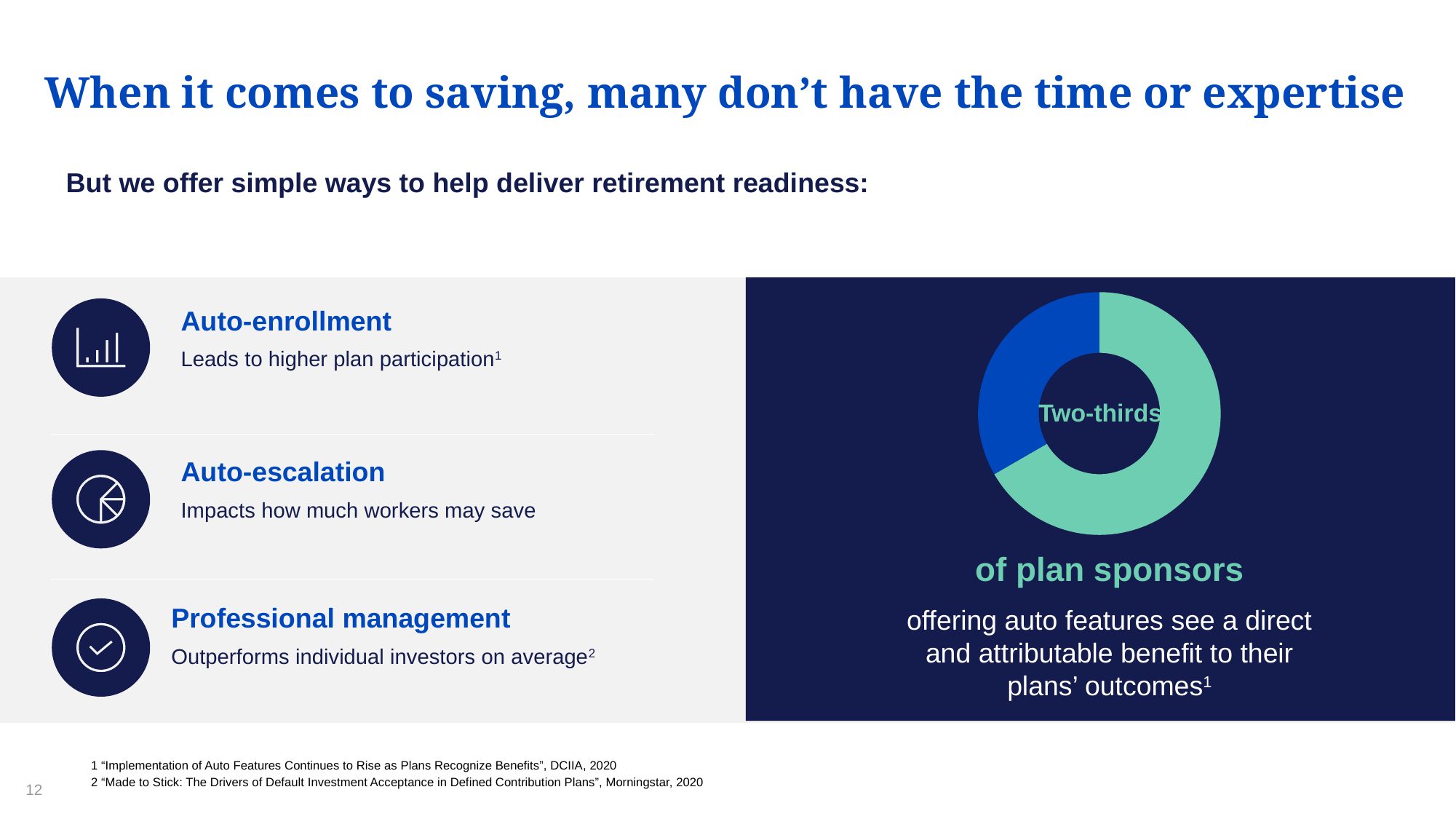
Does the green segment of the donut chart represent more or less than half of the whole? more Which segment of the donut chart is larger, the green one or the blue one? the green one Does the blue segment of the donut chart represent more or less than half of the whole? less Which colour segment of the donut chart is the largest? green What group does the donut chart describe, according to the label directly below it? plan sponsors How many segments does the donut chart have? 2 What text is printed in the centre of the donut chart? Two-thirds What share of plan sponsors does the large green segment of the donut chart represent? Two-thirds Which colour segment of the donut chart is the smallest? blue What kind of chart is shown on the right side of the slide? donut chart